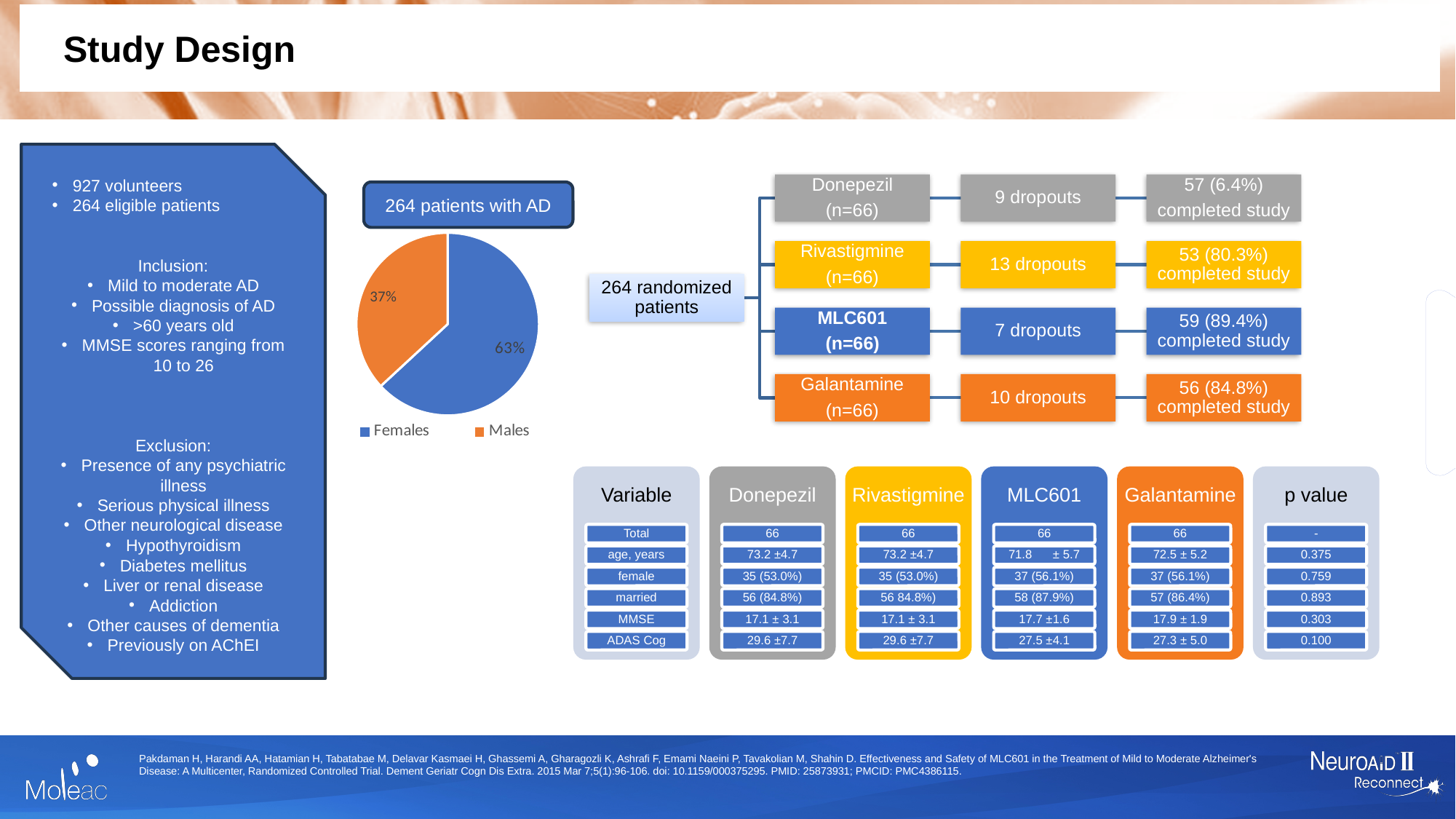
In the pie chart, is the share for Females larger or smaller than the share for Males? larger What percentage of the pie chart is labelled Females? 63% What is the title shown above the pie chart? 264 patients with AD What share of the pie chart does the Males slice represent? 37% What percentage of the pie chart is labelled Males? 37% By how many percentage points does the Females slice exceed the Males slice in the pie chart? 26 percentage points How many slices does the pie chart have? 2 How many entries does the pie chart's legend list? 2 What kind of chart is shown on the slide? pie chart Which category has the largest slice in the pie chart? Females What colour is the Females slice in the pie chart? blue Which category has the smallest slice in the pie chart? Males